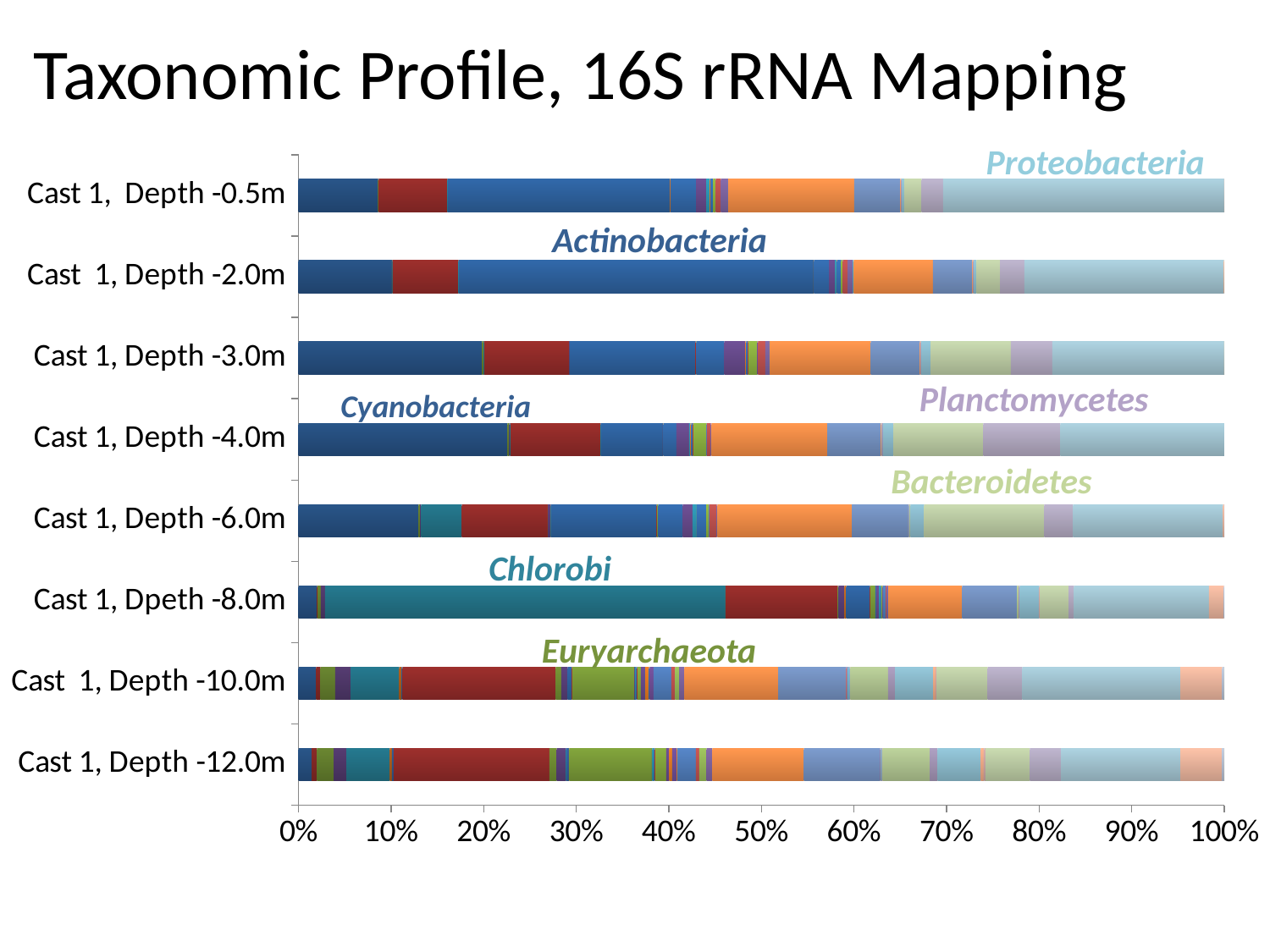
Is the Cyanobacteria share for Cast 1, Depth -4.0m greater or less than 10%? greater Is the Bacteroidetes share for Cast 1, Depth -6.0m greater or less than 10%? greater What kind of chart is shown on the slide? Stacked bar chart Is the Euryarchaeota share for Cast 1, Depth -10.0m greater or less than 10%? less Which depth has the larger Proteobacteria share: Cast 1, Depth -0.5m or Cast 1, Depth -12.0m? Cast 1, Depth -0.5m Which depth has the larger Chlorobi share: Cast 1, Depth -8.0m or Cast 1, Depth -0.5m? Cast 1, Depth -8.0m What is the maximum value shown on the x axis? 100% What is the title of the slide? Taxonomic Profile, 16S rRNA Mapping How many depth samples (bars) are plotted in the chart? 8